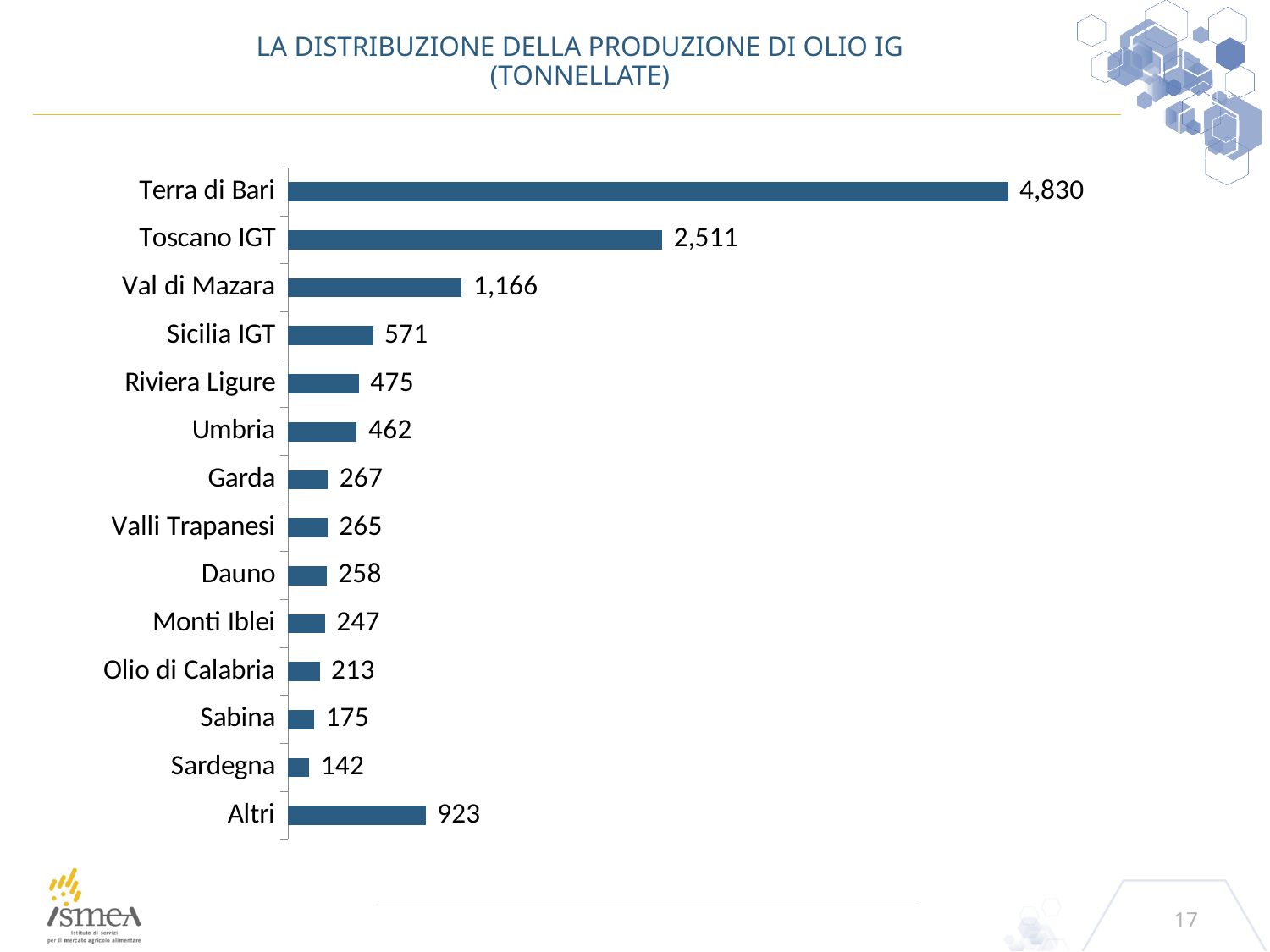
What kind of chart is shown on the slide? Bar chart Which category has the lowest production? Sardegna What is the difference between Terra di Bari and Toscano IGT? 2,319 What is the production value for Altri? 923 What is the production value for Sabina? 175 What unit is given in the chart title? Tonnellate Which is larger, Umbria or Garda? Umbria What is the difference between Sicilia IGT and Riviera Ligure? 96 What is the production value for Val di Mazara? 1,166 How many categories are shown in the chart? 14 What is the production value for Terra di Bari? 4,830 Which category has the highest production? Terra di Bari